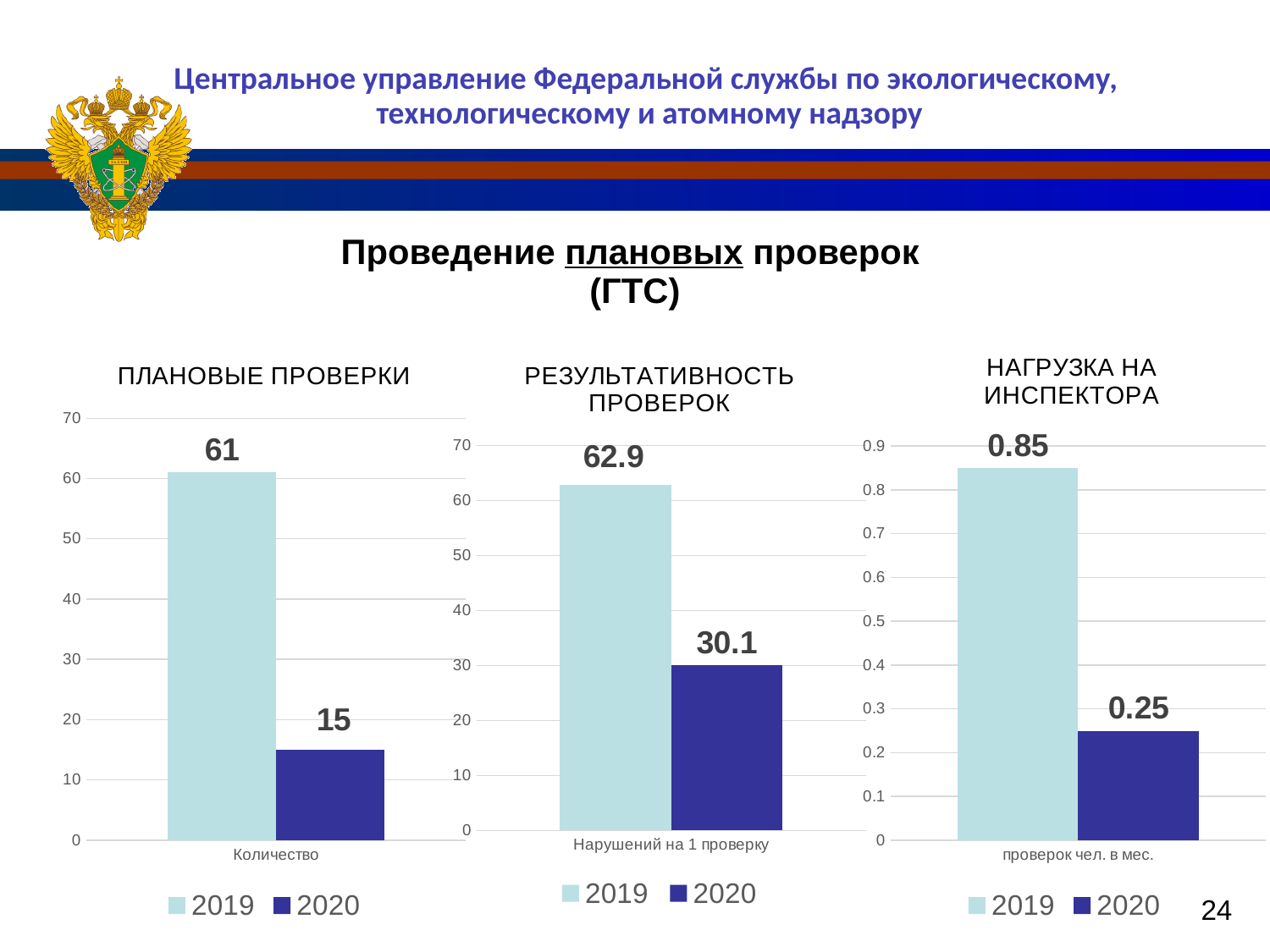
In the 'НАГРУЗКА НА ИНСПЕКТОРА' chart, what is the difference between the 2019 and 2020 values? 0.6 In the 'НАГРУЗКА НА ИНСПЕКТОРА' chart, what is the value for 2019? 0.85 In the 'ПЛАНОВЫЕ ПРОВЕРКИ' chart, what is the value for 2019? 61 What kind of chart is the 'РЕЗУЛЬТАТИВНОСТЬ ПРОВЕРОК' chart? Bar chart How many series does the legend of the 'ПЛАНОВЫЕ ПРОВЕРКИ' chart list? 2 In the 'НАГРУЗКА НА ИНСПЕКТОРА' chart, what is the value for 2020? 0.25 In the 'РЕЗУЛЬТАТИВНОСТЬ ПРОВЕРОК' chart, what is the value for 2020? 30.1 In the 'РЕЗУЛЬТАТИВНОСТЬ ПРОВЕРОК' chart, what is the value for 2019? 62.9 In the 'НАГРУЗКА НА ИНСПЕКТОРА' chart, which year has the lowest value? 2020 In the 'ПЛАНОВЫЕ ПРОВЕРКИ' chart, what is the difference between the 2019 and 2020 values? 46 In the 'ПЛАНОВЫЕ ПРОВЕРКИ' chart, what is the value for 2020? 15 In the 'РЕЗУЛЬТАТИВНОСТЬ ПРОВЕРОК' chart, which year has the higher value? 2019